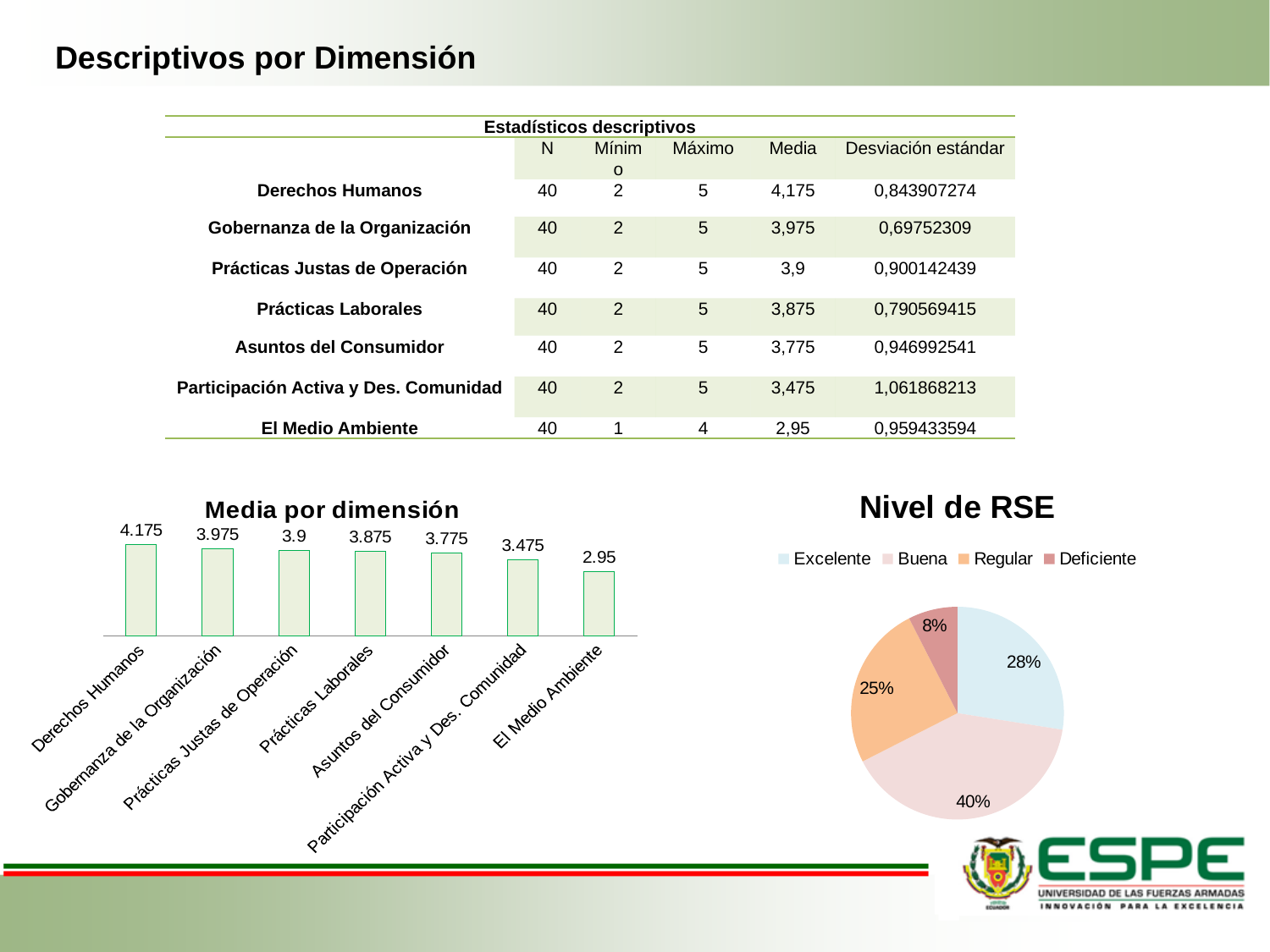
In the 'Media por dimensión' chart, what is the difference between the values for Derechos Humanos and El Medio Ambiente? 1.225 In the 'Media por dimensión' chart, which dimension has the highest mean? Derechos Humanos How many dimensions are plotted in the 'Media por dimensión' chart? 7 In the 'Nivel de RSE' chart, what share does Buena have? 40% In the 'Media por dimensión' chart, which dimension has the lowest mean? El Medio Ambiente In the 'Media por dimensión' chart, do the values rise or fall from left to right? Fall How many categories does the legend of the 'Nivel de RSE' chart list? 4 In the 'Media por dimensión' chart, which is larger: the value for Prácticas Laborales or the value for Participación Activa y Des. Comunidad? Prácticas Laborales What kind of chart is 'Media por dimensión'? Bar chart In the 'Media por dimensión' chart, what is the value for Derechos Humanos? 4.175 In the 'Media por dimensión' chart, what is the value for El Medio Ambiente? 2.95 In the 'Nivel de RSE' chart, which category has the smallest slice? Deficiente